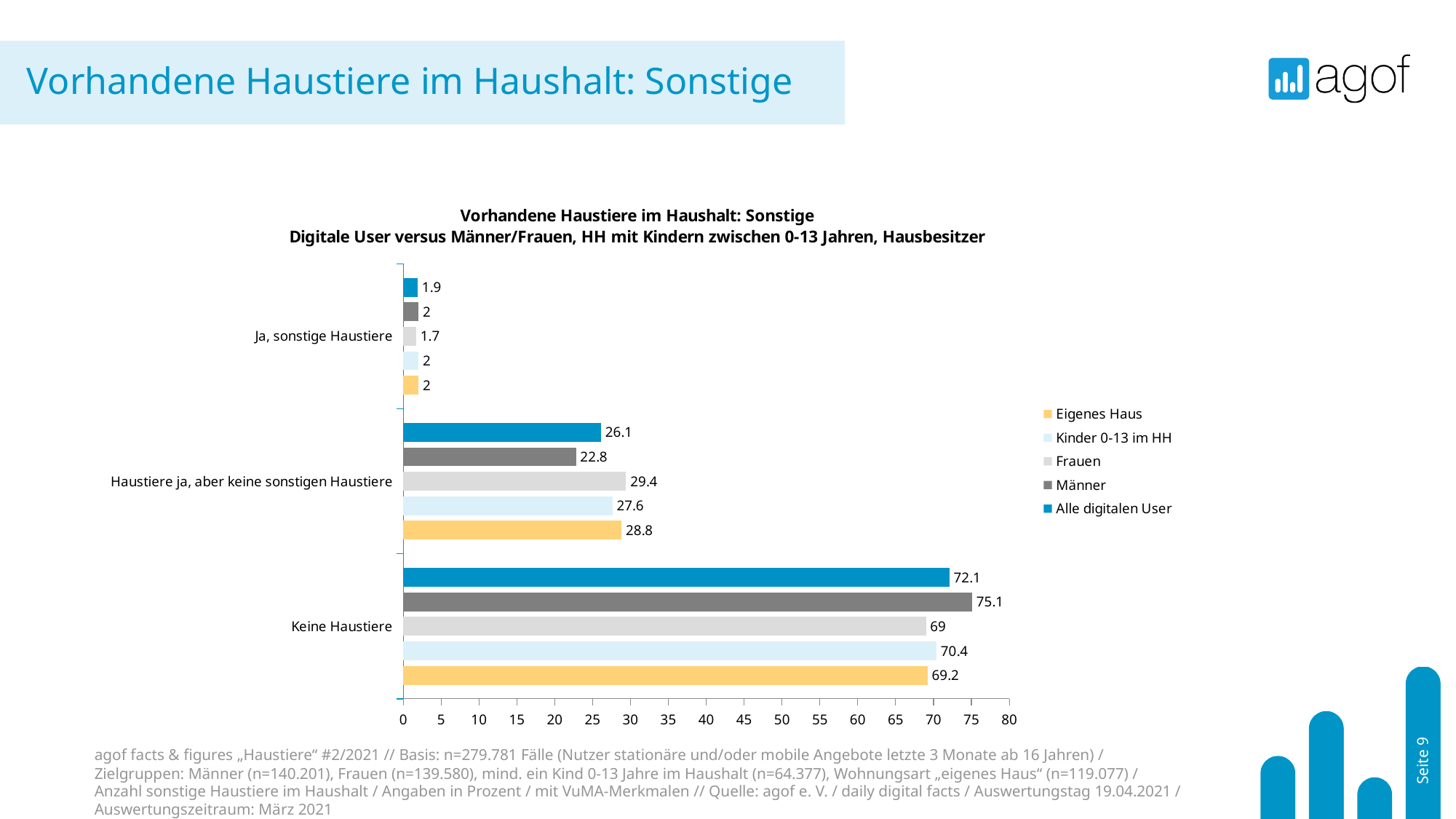
What kind of chart is shown on the slide? Bar chart What is the value for Eigenes Haus in the category "Keine Haustiere"? 69.2 How many categories are shown on the chart? 3 Which series is shown in yellow in the legend? Eigenes Haus What is the value for Alle digitalen User in the category "Ja, sonstige Haustiere"? 1.9 What is the value for Männer in the category "Keine Haustiere"? 75.1 What is the difference between the Männer and Frauen values in the category "Keine Haustiere"? 6.1 What is the value for Frauen in the category "Haustiere ja, aber keine sonstigen Haustiere"? 29.4 Which series has the lowest value in the category "Haustiere ja, aber keine sonstigen Haustiere"? Männer How many series does the legend list? 5 In the category "Haustiere ja, aber keine sonstigen Haustiere", which is larger: the value for Kinder 0-13 im HH or the value for Eigenes Haus? Eigenes Haus Which series has the highest value in the category "Keine Haustiere"? Männer